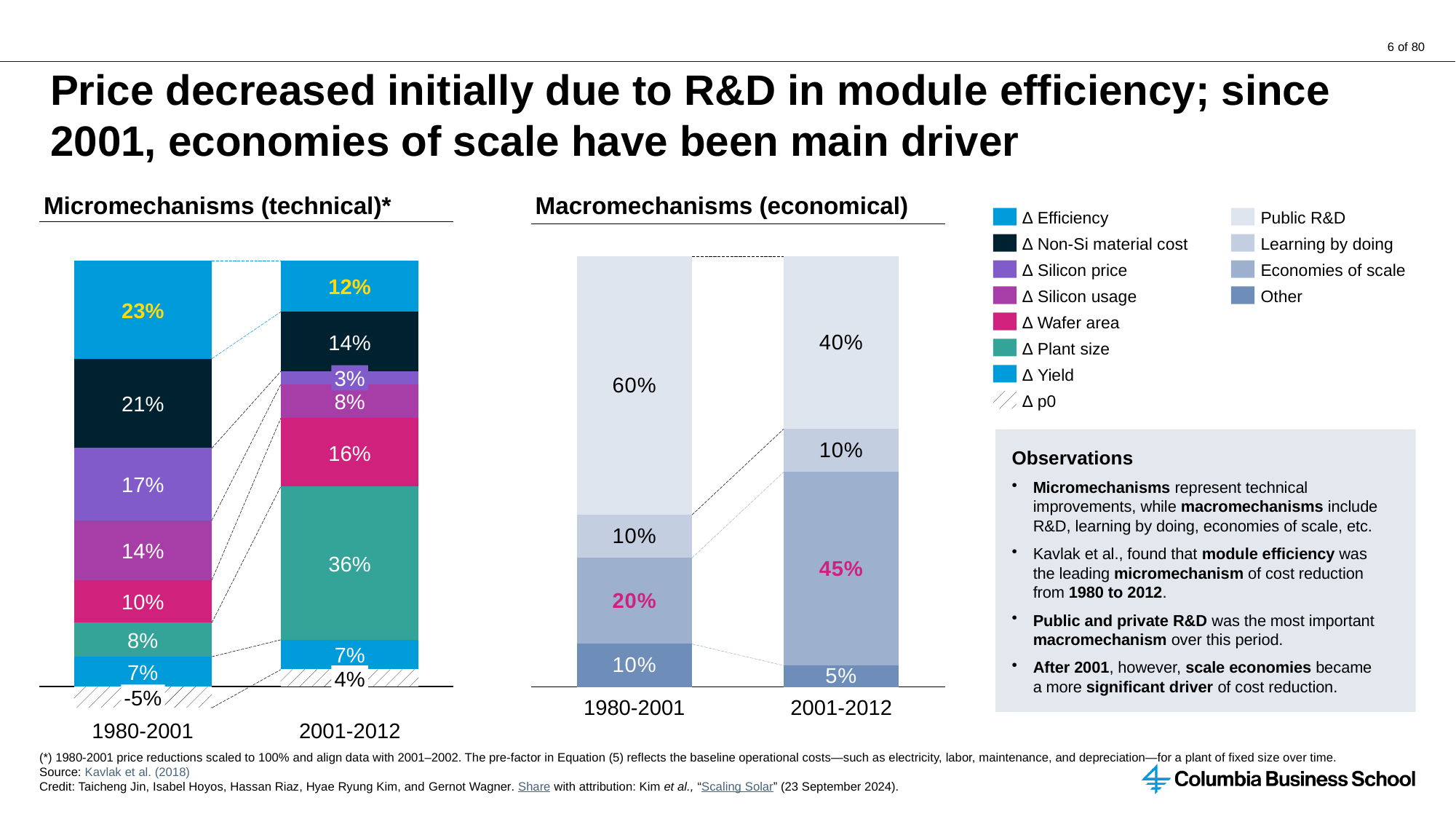
In the Micromechanisms (technical) chart, what is the value of Δ Plant size for 2001-2012? 36% In the Micromechanisms (technical) chart, what is the value of Δ Efficiency for 1980-2001? 23% In the Micromechanisms (technical) chart, which mechanism has the largest segment in the 2001-2012 bar? Δ Plant size In the Macromechanisms (economical) chart, what is the value of Economies of scale for 2001-2012? 45% In the Macromechanisms (economical) chart, what is the value of Public R&D for 1980-2001? 60% In the Micromechanisms (technical) chart, how much larger is Δ Efficiency in 1980-2001 than in 2001-2012? 11 percentage points In the Macromechanisms (economical) chart, by how many percentage points did Economies of scale increase from 1980-2001 to 2001-2012? 25 percentage points In the Macromechanisms (economical) chart, does the value for Other rise or fall from 1980-2001 to 2001-2012? fall In the Macromechanisms (economical) chart, which mechanism has the smallest segment in the 2001-2012 bar? Other In the Micromechanisms (technical) chart, what is the value of Δ p0 for 1980-2001? -5% What kind of chart is the Macromechanisms (economical) chart? stacked bar chart In the Macromechanisms (economical) chart, which period has the larger Public R&D share, 1980-2001 or 2001-2012? 1980-2001